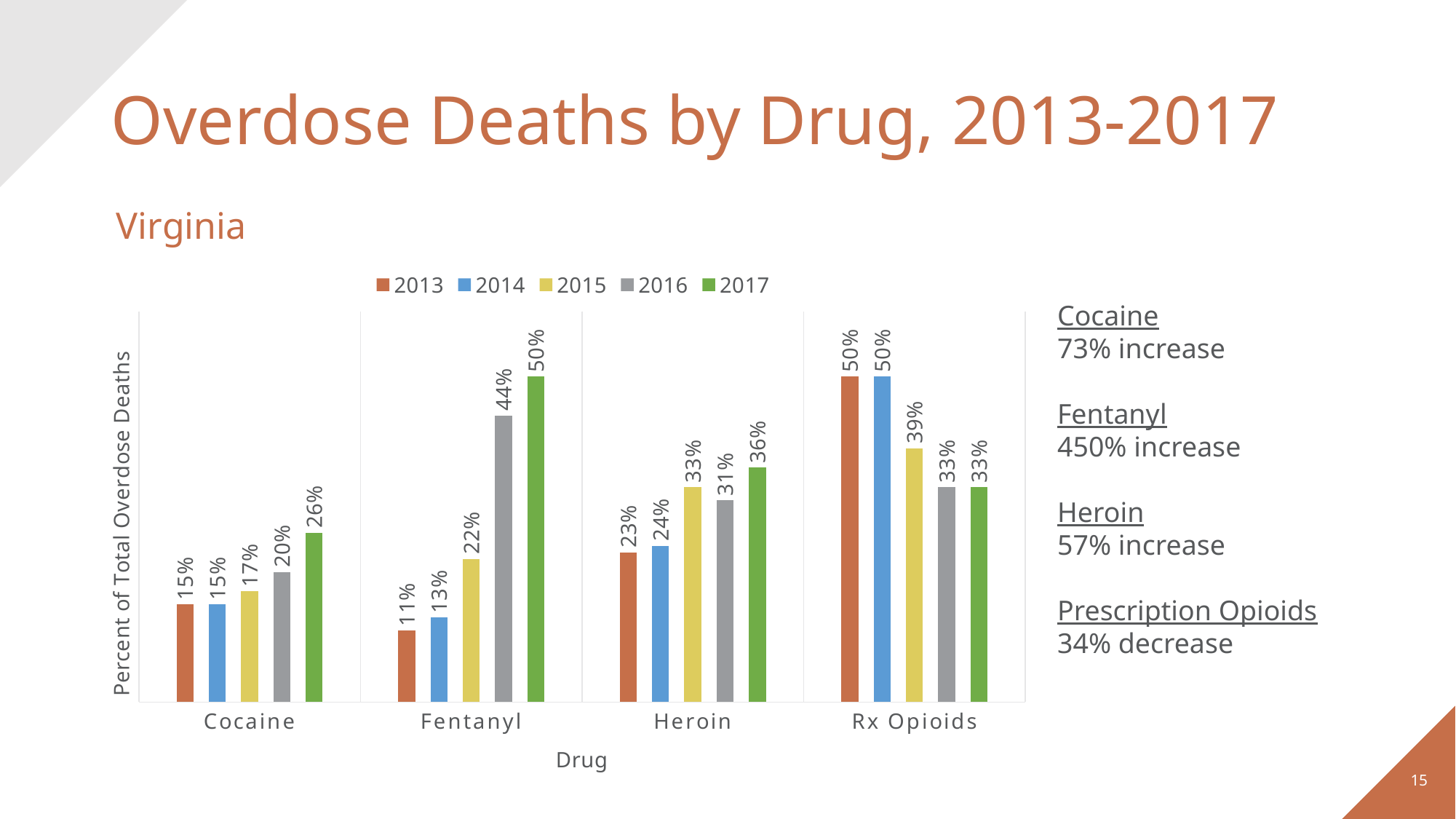
What is the value for Fentanyl in 2017? 50% What is the value for Heroin in 2015? 33% What is the value for Rx Opioids in 2016? 33% How many series does the legend list? 5 Which drug has the highest value in 2013? Rx Opioids Which drug has the lowest value in 2014? Fentanyl Do the values for Rx Opioids rise or fall from 2013 to 2017? Fall What is the value for Cocaine in 2013? 15% Which is larger, the 2017 value for Heroin or the 2017 value for Rx Opioids? Heroin How many drug categories are shown on the x axis? 4 What kind of chart is shown on the slide? Bar chart What is the difference between the 2017 and 2013 values for Fentanyl? 39%